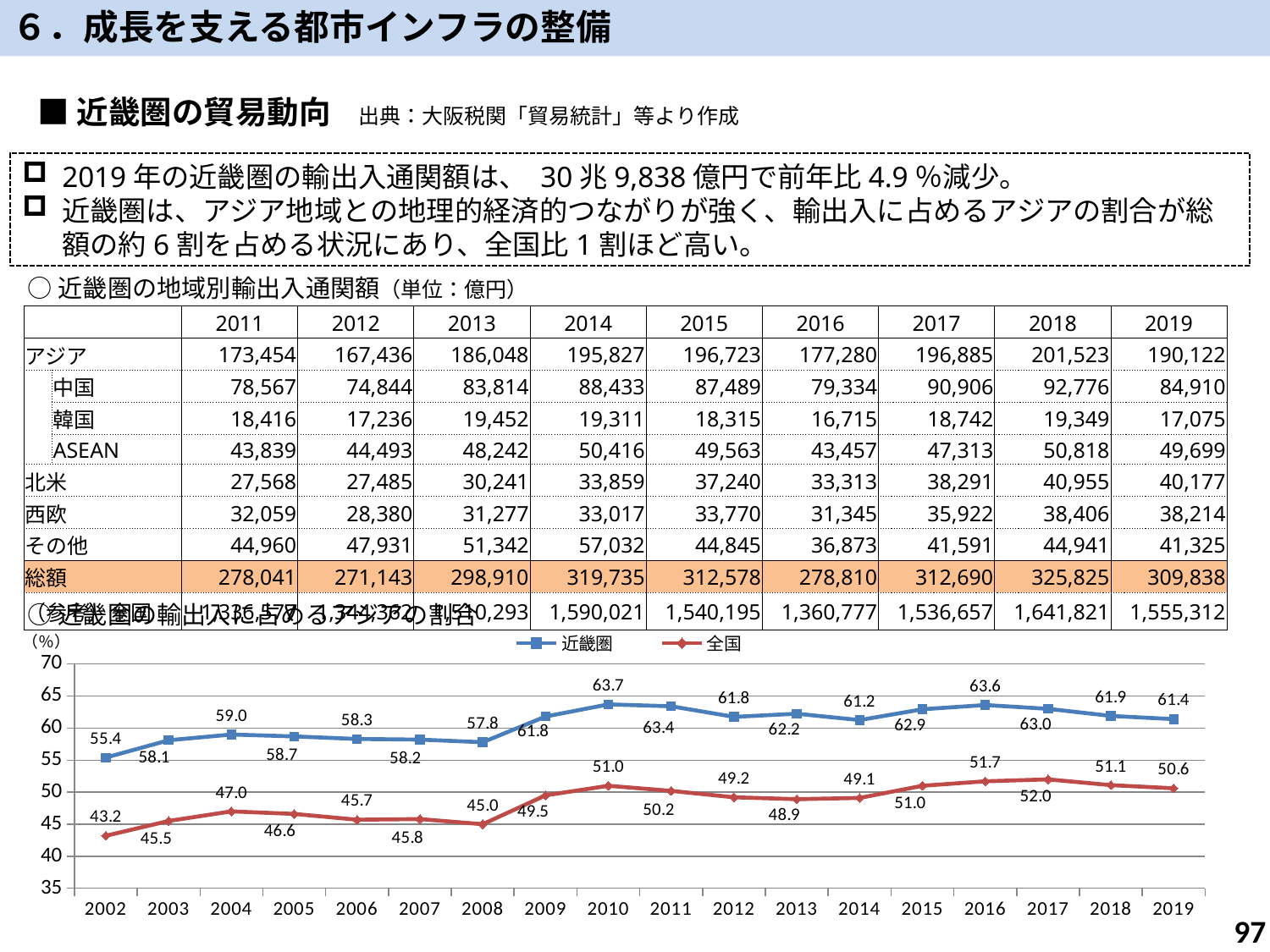
What are the two series named in the legend of the line chart? 近畿圏 and 全国 In the line chart, does the 近畿圏 series rise or fall from 2002 to 2010? rise How many years are plotted along the x axis of the line chart? 18 What kind of chart is shown at the bottom of the slide? line chart In the line chart, what is the value for 近畿圏 in 2002? 55.4 In the line chart, what is the value for 全国 in 2010? 51.0 In the line chart, which year has the lowest value for 全国? 2002 In the line chart, what is the difference between 近畿圏 and 全国 in 2019? 10.8 How many series does the legend of the line chart list? 2 In the line chart, which series has the larger value in 2010, 近畿圏 or 全国? 近畿圏 In the line chart, what is the value for 近畿圏 in 2019? 61.4 In the line chart, which year has the lowest value for 近畿圏? 2002